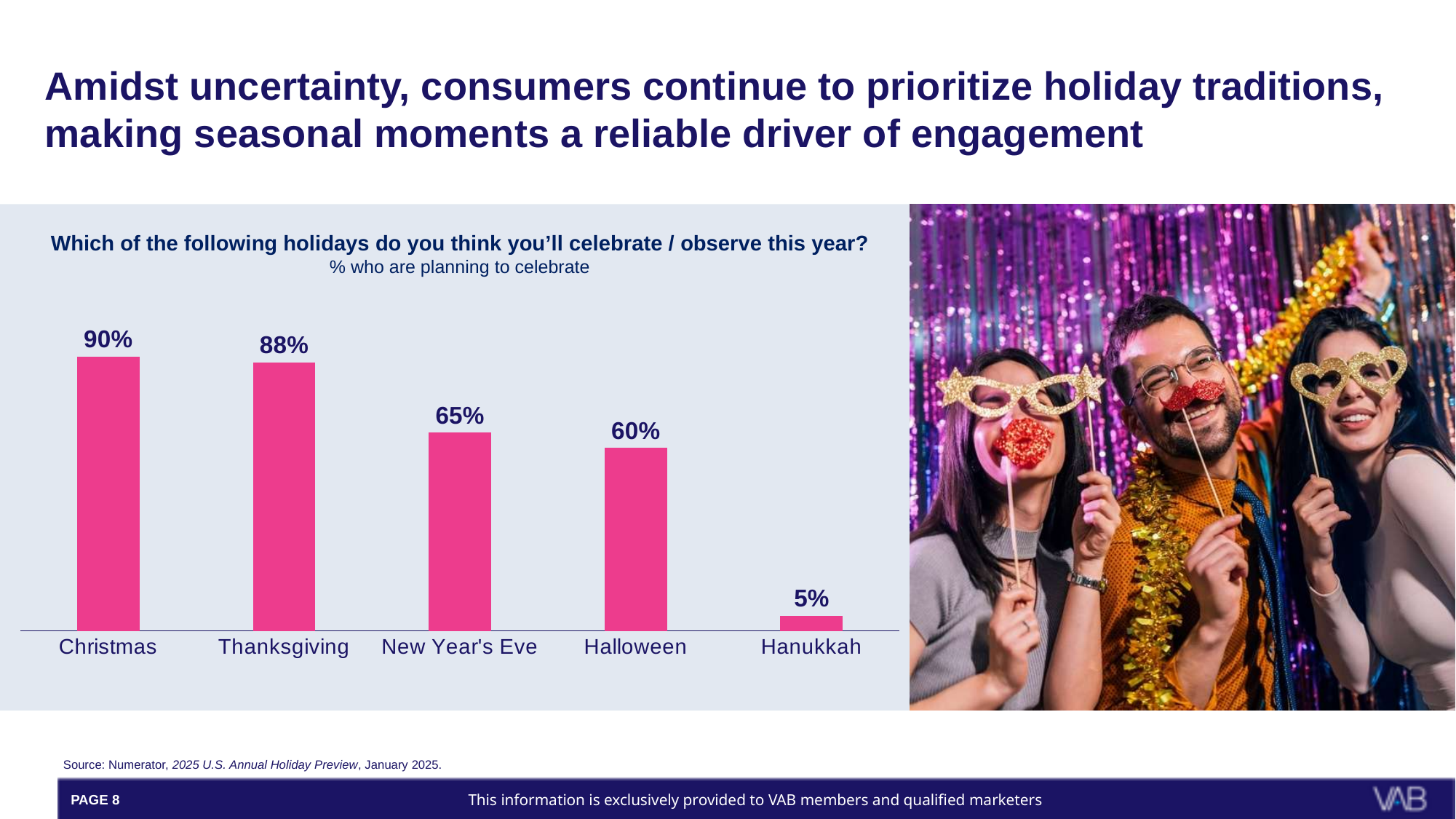
What percentage of respondents are planning to celebrate Christmas? 90% Which holiday has the lowest share of people planning to celebrate it? Hanukkah What percentage of respondents are planning to celebrate Halloween? 60% Which has a higher share of people planning to celebrate, New Year's Eve or Halloween? New Year's Eve Which holiday has the highest share of people planning to celebrate it? Christmas How many holidays are shown in the chart? 5 What kind of chart is shown on the slide? Bar chart What is the difference in percentage points between Christmas and Thanksgiving? 2 percentage points What is the source cited for the chart data? Numerator, 2025 U.S. Annual Holiday Preview, January 2025 What is the difference in percentage points between New Year's Eve and Halloween? 5 percentage points Do the values rise or fall moving from left to right across the chart? Fall What percentage of respondents are planning to celebrate Hanukkah? 5%